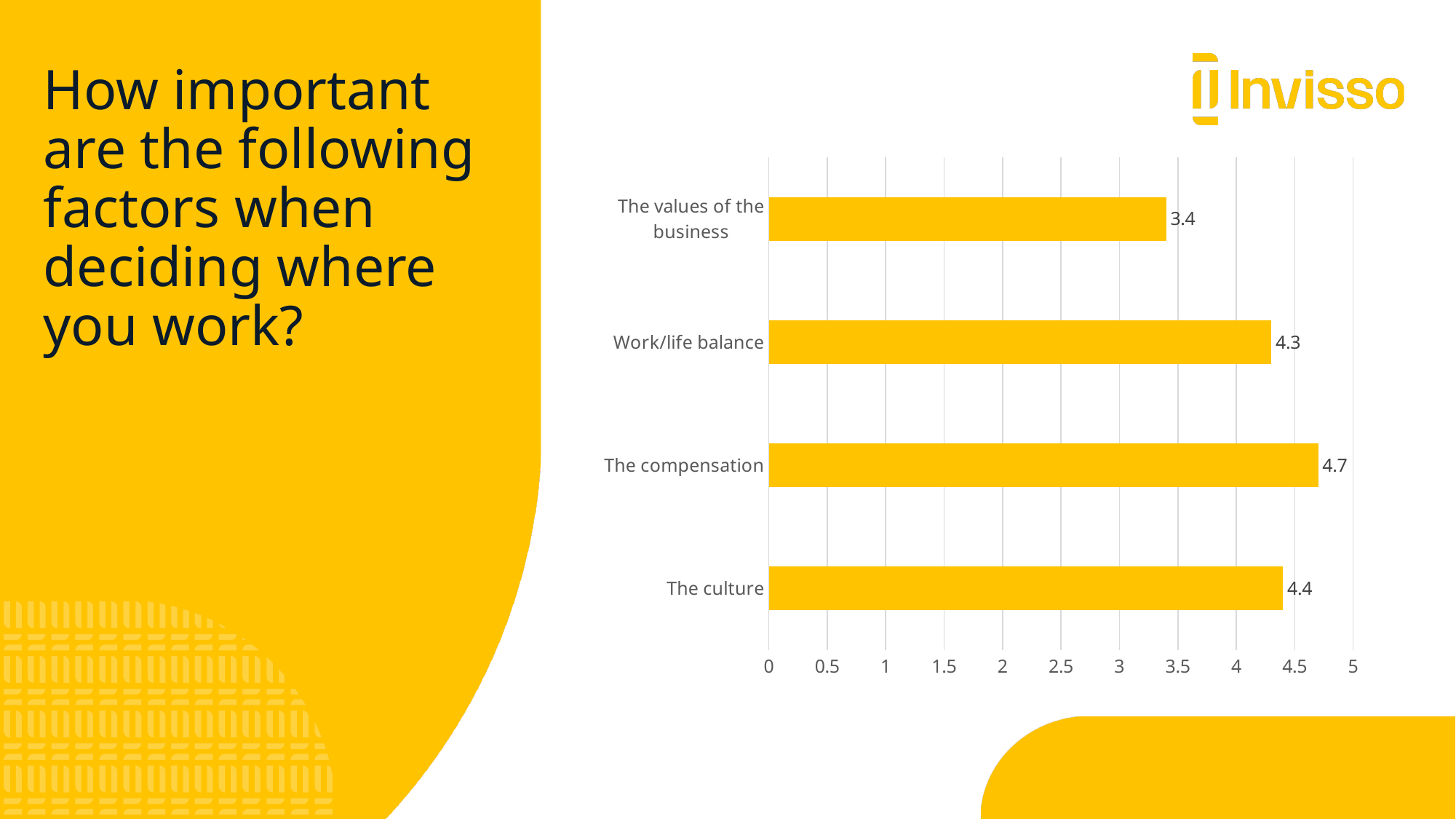
Which is larger, the value for The culture or the value for Work/life balance? The culture What is the difference between the values for The compensation and The values of the business? 1.3 Is the value for The values of the business greater or less than 4? less What is the value for The culture? 4.4 What is the maximum value shown on the horizontal axis? 5 What is the value for Work/life balance? 4.3 How many factors are shown in the chart? 4 What is the value for The compensation? 4.7 What is the value for The values of the business? 3.4 Which factor has the lowest value? The values of the business Which factor has the highest value? The compensation What kind of chart is shown on the slide? Bar chart